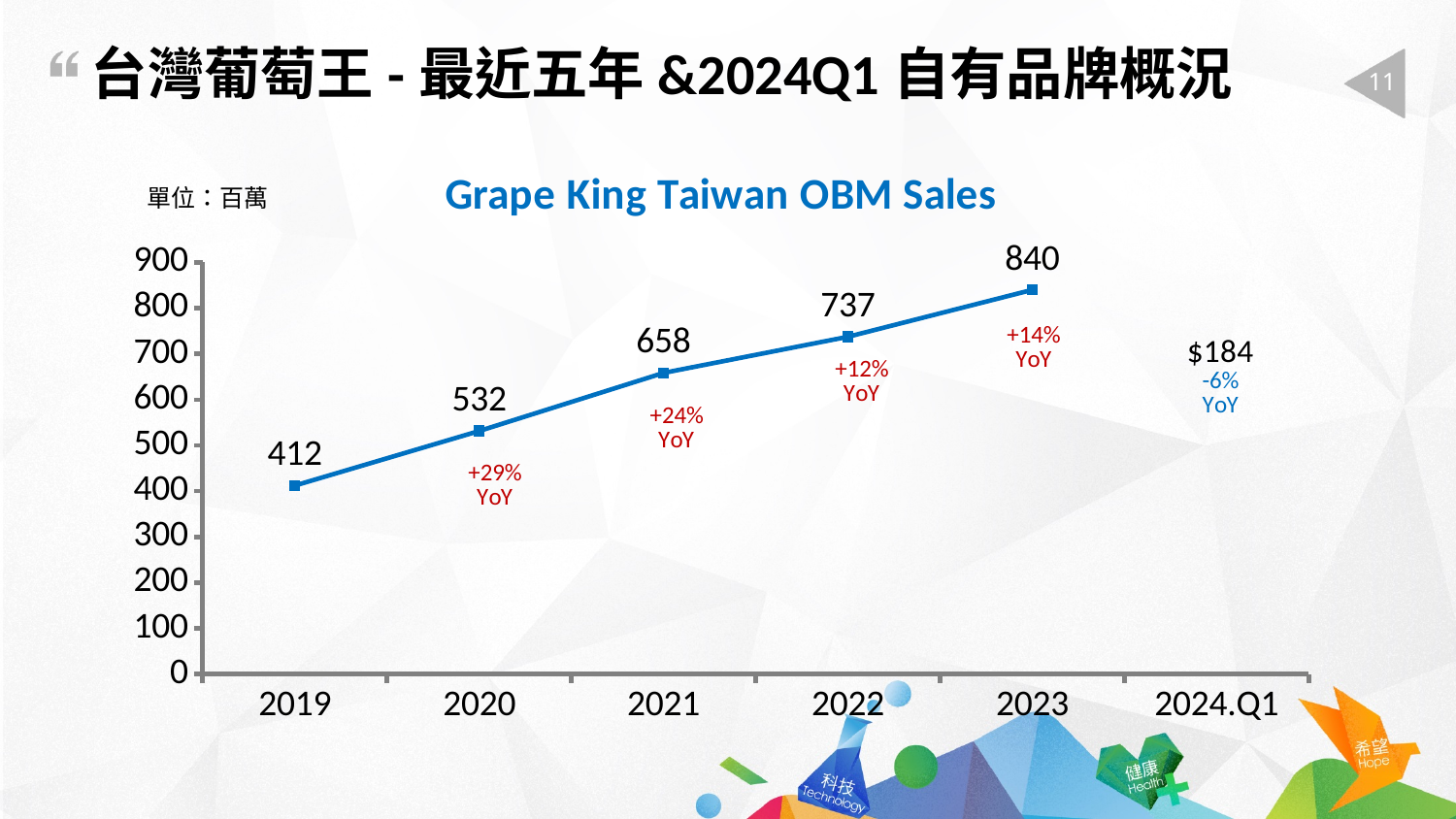
What is the OBM sales value for 2023? 840 Which year from 2019 to 2023 has the lowest OBM sales? 2019 Which year from 2019 to 2023 has the highest OBM sales? 2023 Do the OBM sales values rise or fall from 2019 to 2023? rise What is the title of the chart? Grape King Taiwan OBM Sales What is the difference between the 2023 and 2022 OBM sales values? 103 What is the OBM sales value for 2019? 412 What is the YoY change shown for 2020? +29% What is the YoY change shown for 2024.Q1? -6% Which is larger, the OBM sales value for 2020 or for 2022? 2022 What is the OBM sales value for 2021? 658 What type of chart is shown on the slide? line chart